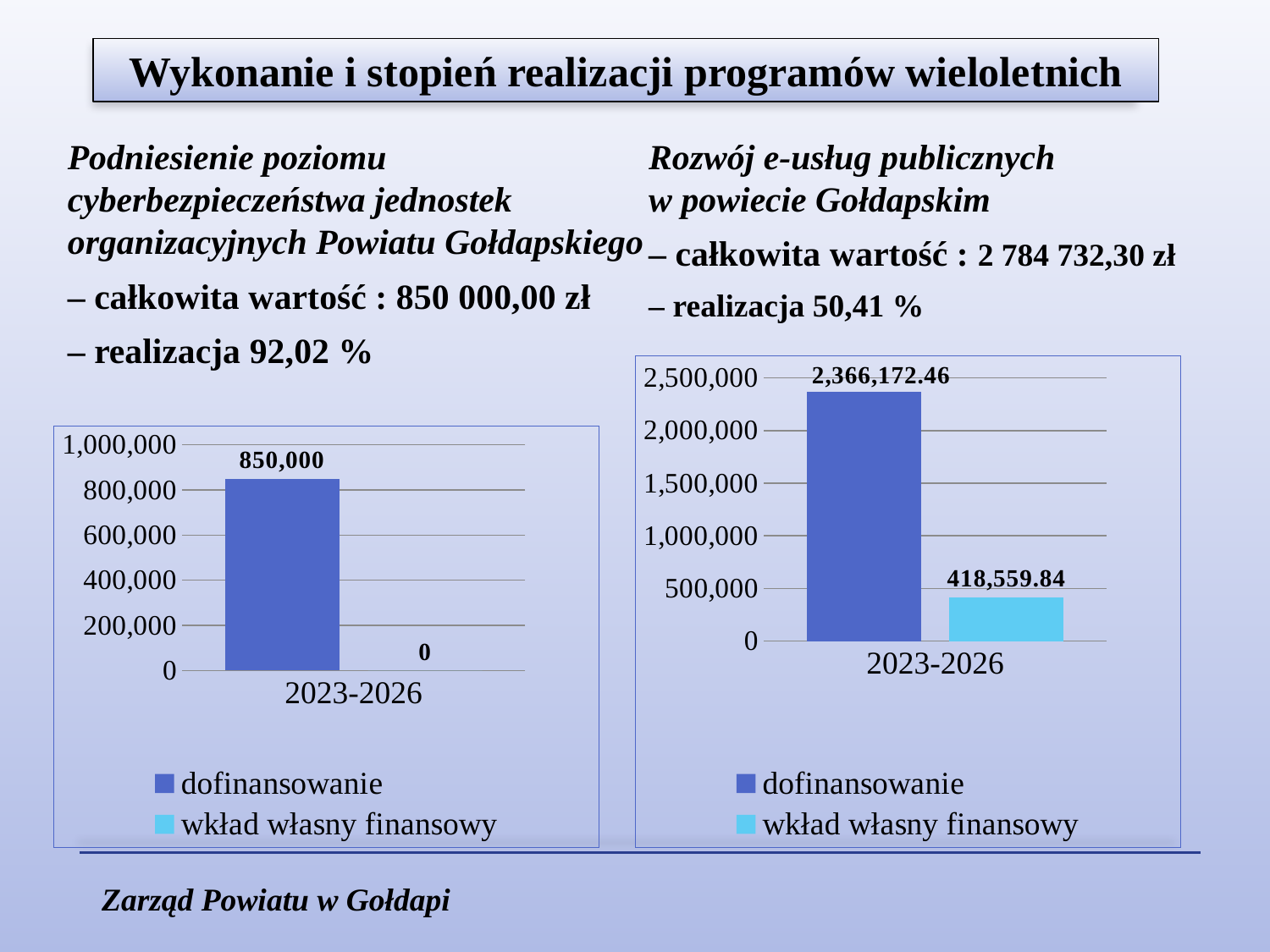
In the left chart, is the value for dofinansowanie greater or less than 800,000? greater What type of chart is the right chart? bar chart What is the category label on the x axis of the right chart? 2023-2026 In the right chart, what is the difference between dofinansowanie and wkład własny finansowy? 1,947,612.62 In the right chart, what is the combined total of dofinansowanie and wkład własny finansowy? 2,784,732.30 In the left chart, what is the value for wkład własny finansowy in 2023-2026? 0 How many series does the legend of the left chart list? 2 In the right chart, is the value for wkład własny finansowy greater or less than 500,000? less In the right chart, what is the value for wkład własny finansowy in 2023-2026? 418,559.84 In the right chart, which series has the higher value: dofinansowanie or wkład własny finansowy? dofinansowanie In the left chart, what is the value for dofinansowanie in 2023-2026? 850,000 In the right chart, what is the value for dofinansowanie in 2023-2026? 2,366,172.46